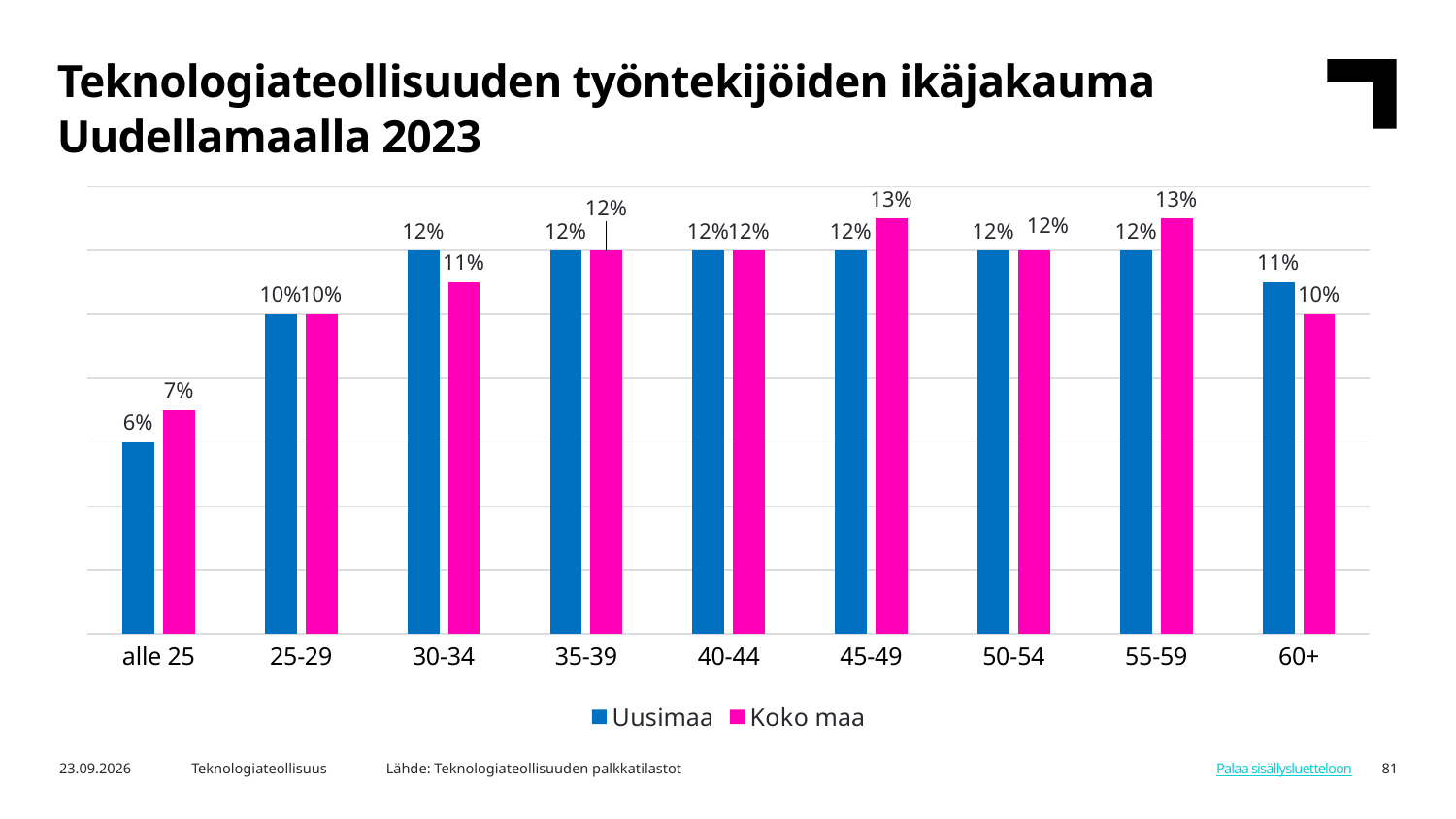
What is the Uusimaa value for the alle 25 age group? 6% What is the Koko maa value for the 60+ age group? 10% How many series does the legend list? 2 Which is larger for the 55-59 age group, the Uusimaa value or the Koko maa value? Koko maa What kind of chart is shown on the slide? Bar chart What is the Uusimaa value for the 30-34 age group? 12% Which age group has the lowest Koko maa value? alle 25 How many age groups are shown on the x axis? 9 What is the difference between the Koko maa and Uusimaa values for the alle 25 age group? 1% Which is larger for the 30-34 age group, the Uusimaa value or the Koko maa value? Uusimaa What is the Koko maa value for the 45-49 age group? 13% Which age group has the lowest Uusimaa value? alle 25